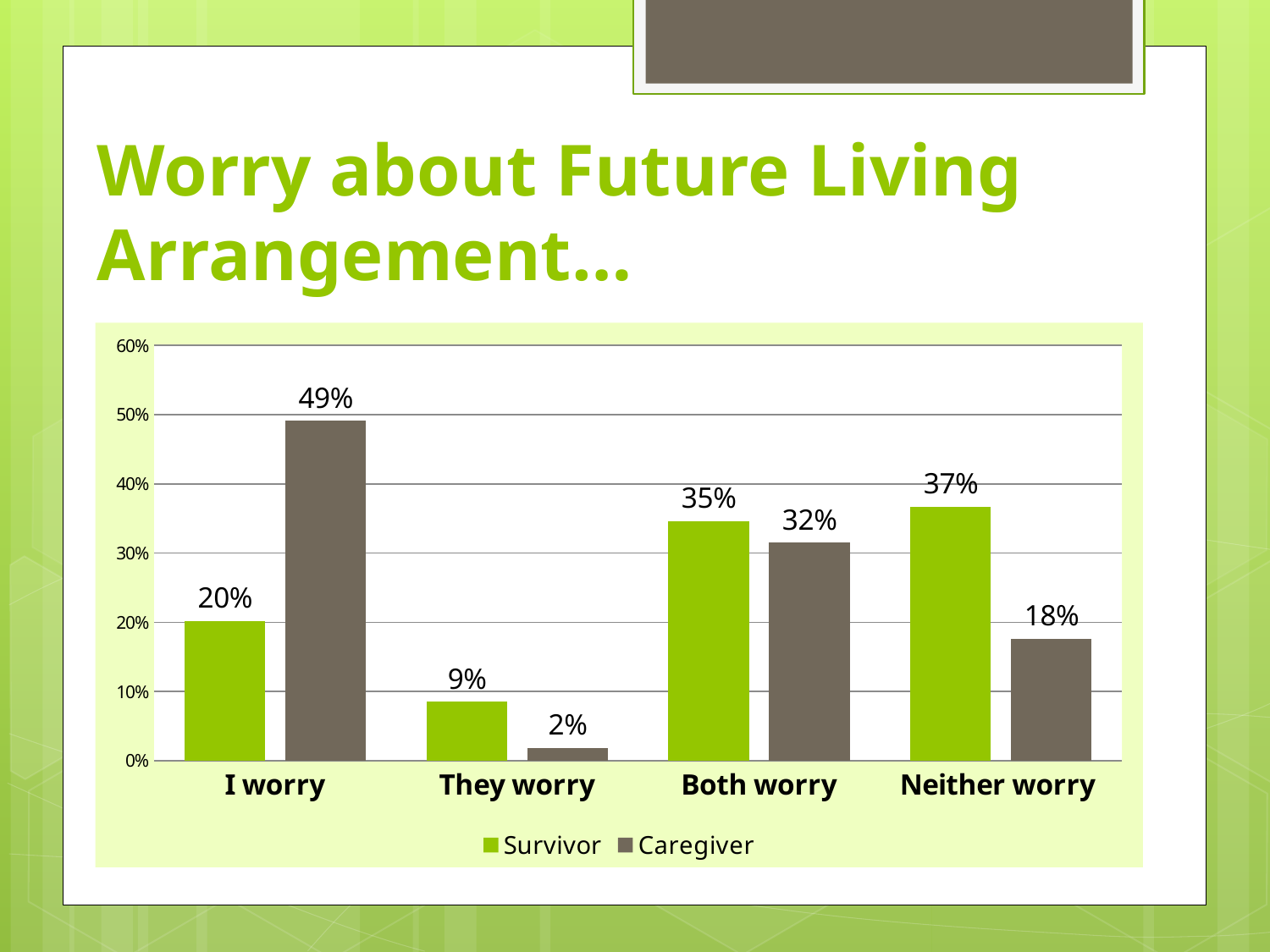
What is the Caregiver value for "Both worry"? 32% What is the Caregiver value for "They worry"? 2% How many series does the legend list? 2 How many categories are shown on the x axis? 4 Which category has the highest Caregiver value? I worry Is the Caregiver value for "I worry" greater or less than 40%? greater What is the Survivor value for "I worry"? 20% Which category has the lowest Survivor value? They worry What kind of chart is shown on the slide? bar chart What is the difference between the Caregiver and Survivor values for "I worry"? 29% What is the difference between the Survivor and Caregiver values for "Neither worry"? 19% Which is larger for "Both worry": the Survivor value or the Caregiver value? Survivor